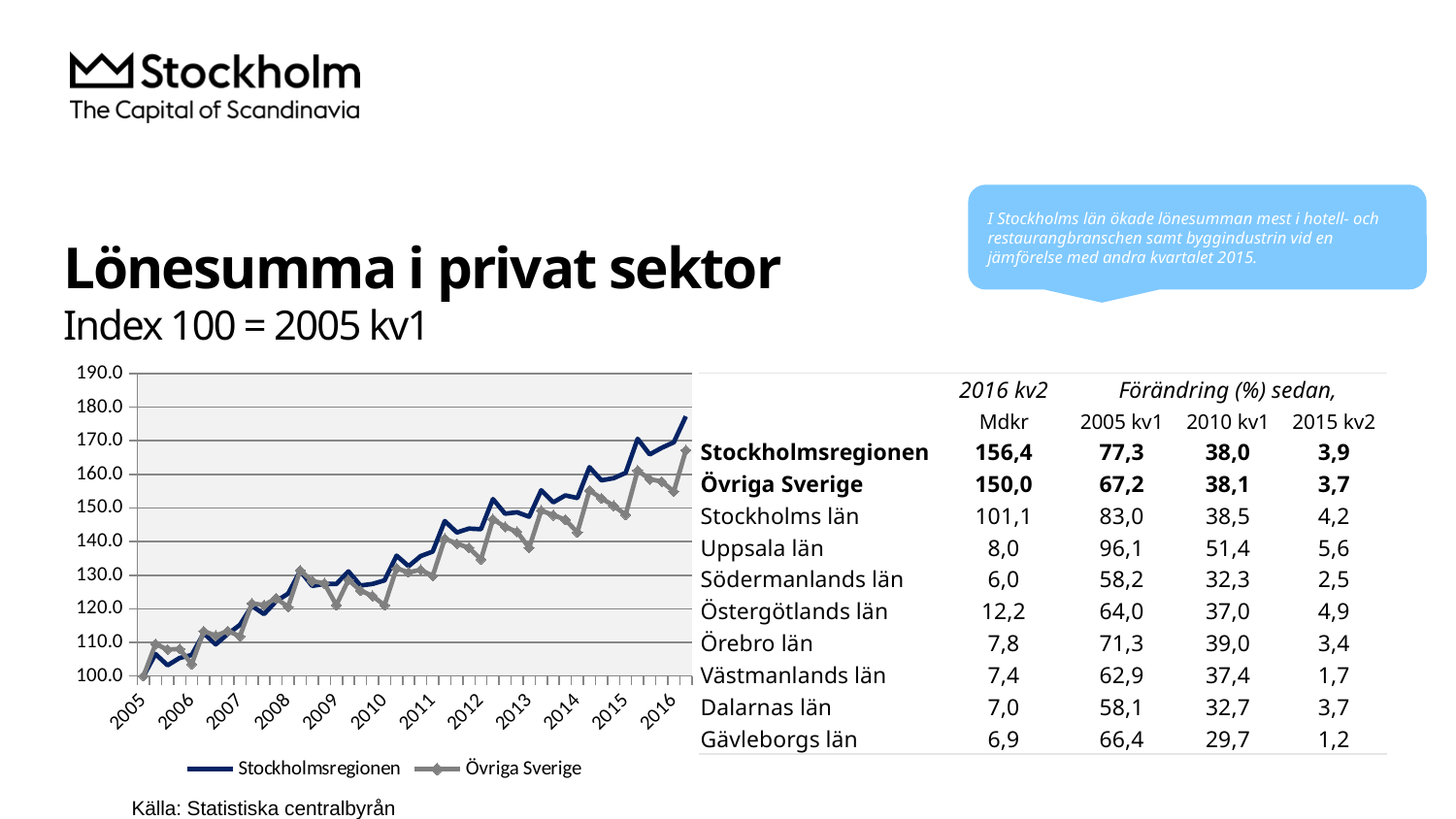
Which series reaches the highest value at the end of the chart in 2016? Stockholmsregionen Is the final 2016 value for Stockholmsregionen greater or less than 170? greater Is the final 2016 value for Övriga Sverige greater or less than 160? greater Is the value for Övriga Sverige at the start of 2009 greater or less than 130? less What is the source given below the chart? Statistiska centralbyrån What kind of chart is shown on the slide? line chart How many years are labelled on the x axis of the chart? 12 How many series does the chart legend list? 2 Do the values in the chart generally rise or fall from 2005 to 2016? rise At the last point in 2016, which series has the larger value, Stockholmsregionen or Övriga Sverige? Stockholmsregionen What is the index value of both series at the start of the chart (2005 kv1)? 100.0 Which two series are shown in the chart legend? Stockholmsregionen and Övriga Sverige